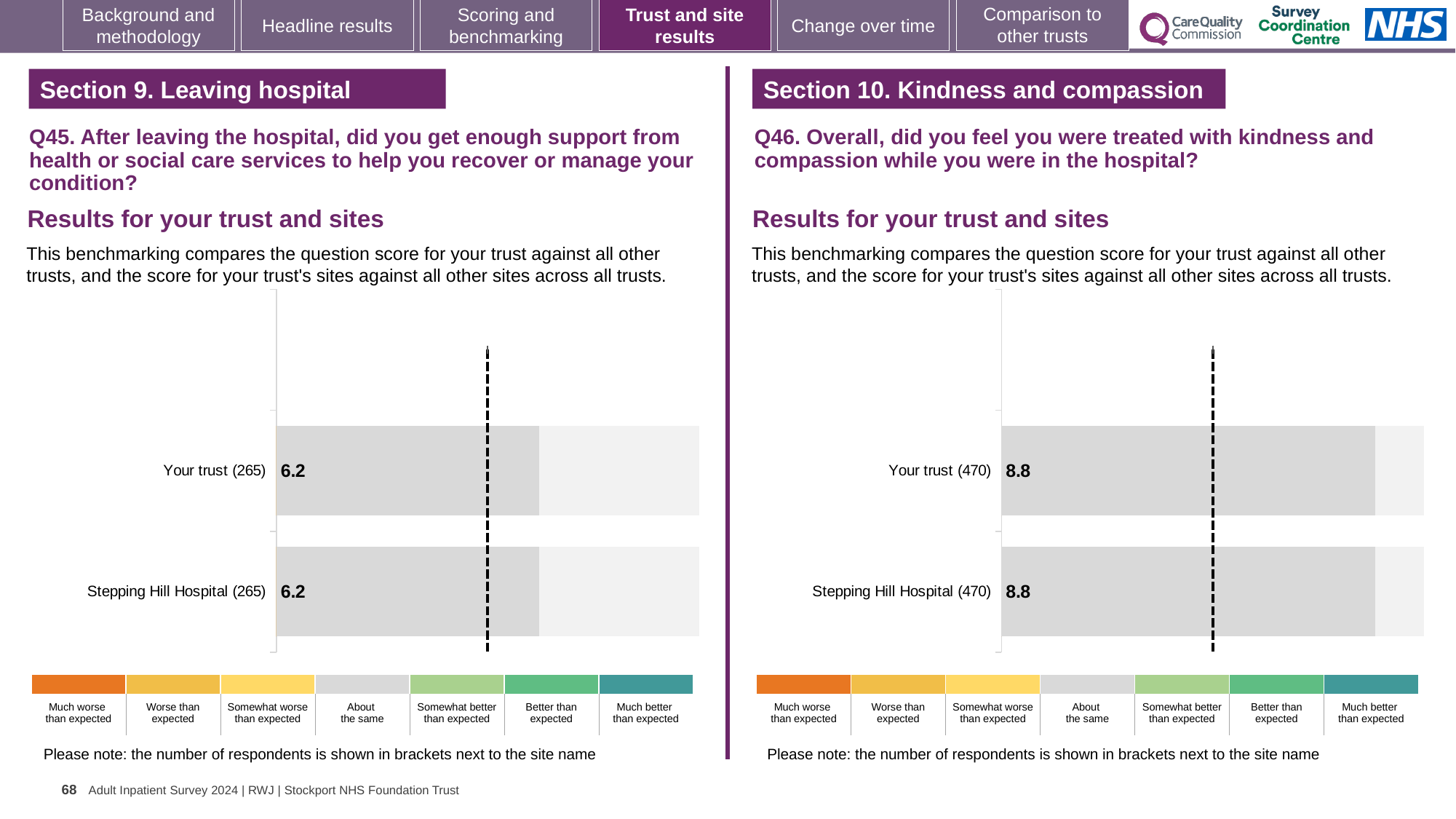
What is the difference between the Your trust score in the Q46 chart on the right and the Your trust score in the Q45 chart on the left? 2.6 In the Q46 chart on the right, are the scores for Your trust and Stepping Hill Hospital the same or different? The same In the Q46 chart on the right, what is the score for Stepping Hill Hospital? 8.8 In the Q45 chart on the left, what is the score for Your trust? 6.2 How many bars are plotted in the Q46 chart on the right? 2 In the Q45 chart on the left, how many respondents are shown in brackets for Your trust? 265 In the Q46 chart on the right, how many respondents are shown in brackets for Stepping Hill Hospital? 470 What kind of chart is used for the Q45 results on the left? Bar chart Which is larger: the Your trust score in the Q45 chart on the left or the Your trust score in the Q46 chart on the right? Q46 chart on the right How many bars are plotted in the Q45 chart on the left? 2 In the Q45 chart on the left, what is the score for Stepping Hill Hospital? 6.2 In the Q46 chart on the right, what is the score for Your trust? 8.8